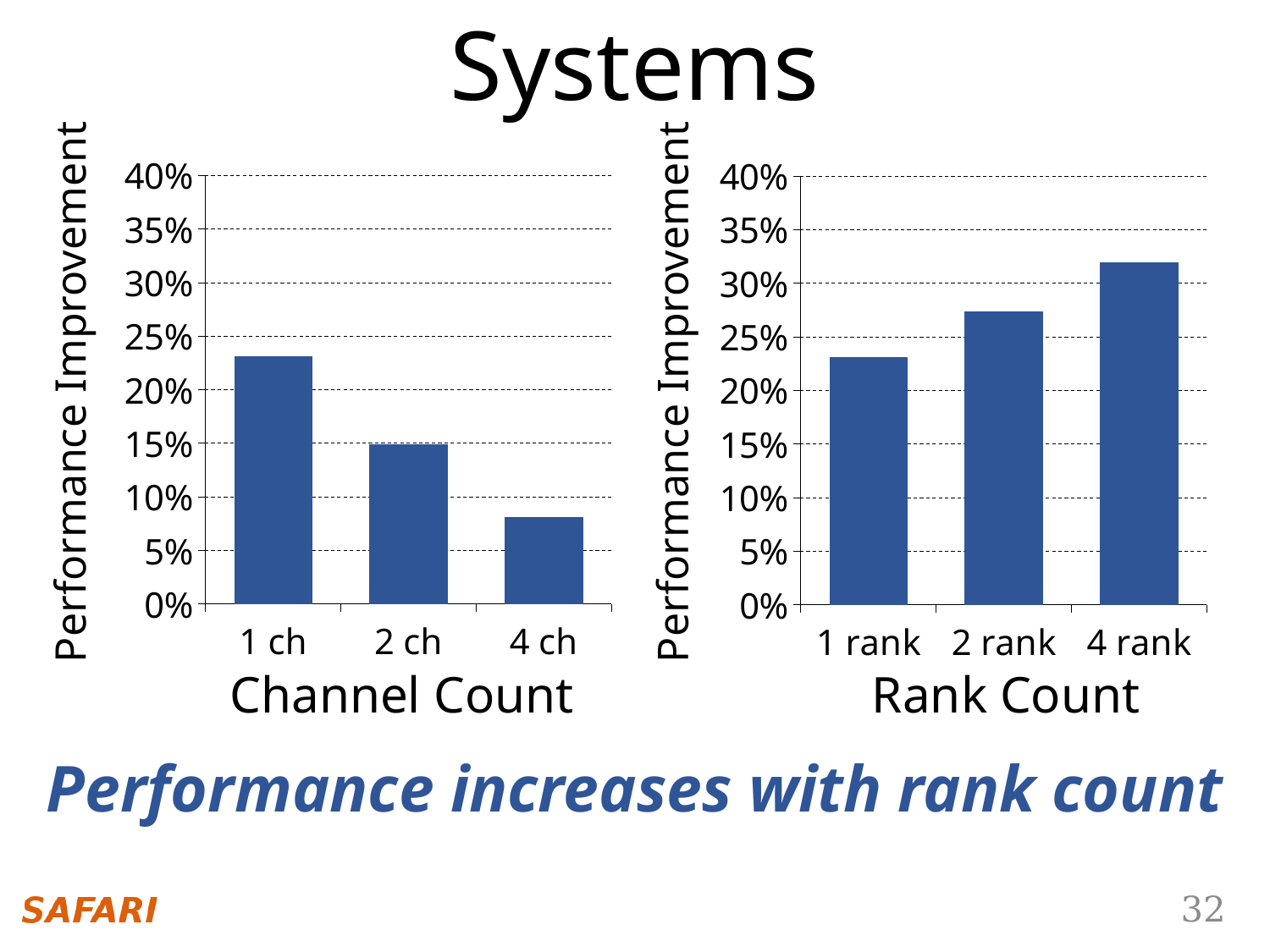
In the Rank Count chart, do the values rise or fall as the rank count increases? rise In the Channel Count chart, which channel count has the lowest performance improvement? 4 ch In the Rank Count chart, which rank count has the highest performance improvement? 4 rank What kind of chart is the Channel Count chart? bar chart In the Channel Count chart, is the value for 4 ch greater or less than 10%? less In the Rank Count chart, is the value for 2 rank greater or less than 25%? greater In the Channel Count chart, which channel count has the highest performance improvement? 1 ch In the Rank Count chart, is the value for 4 rank greater or less than 30%? greater In the Rank Count chart, which rank count has the lowest performance improvement? 1 rank In the Channel Count chart, do the values rise or fall as the channel count increases? fall How many categories are shown in the Rank Count chart? 3